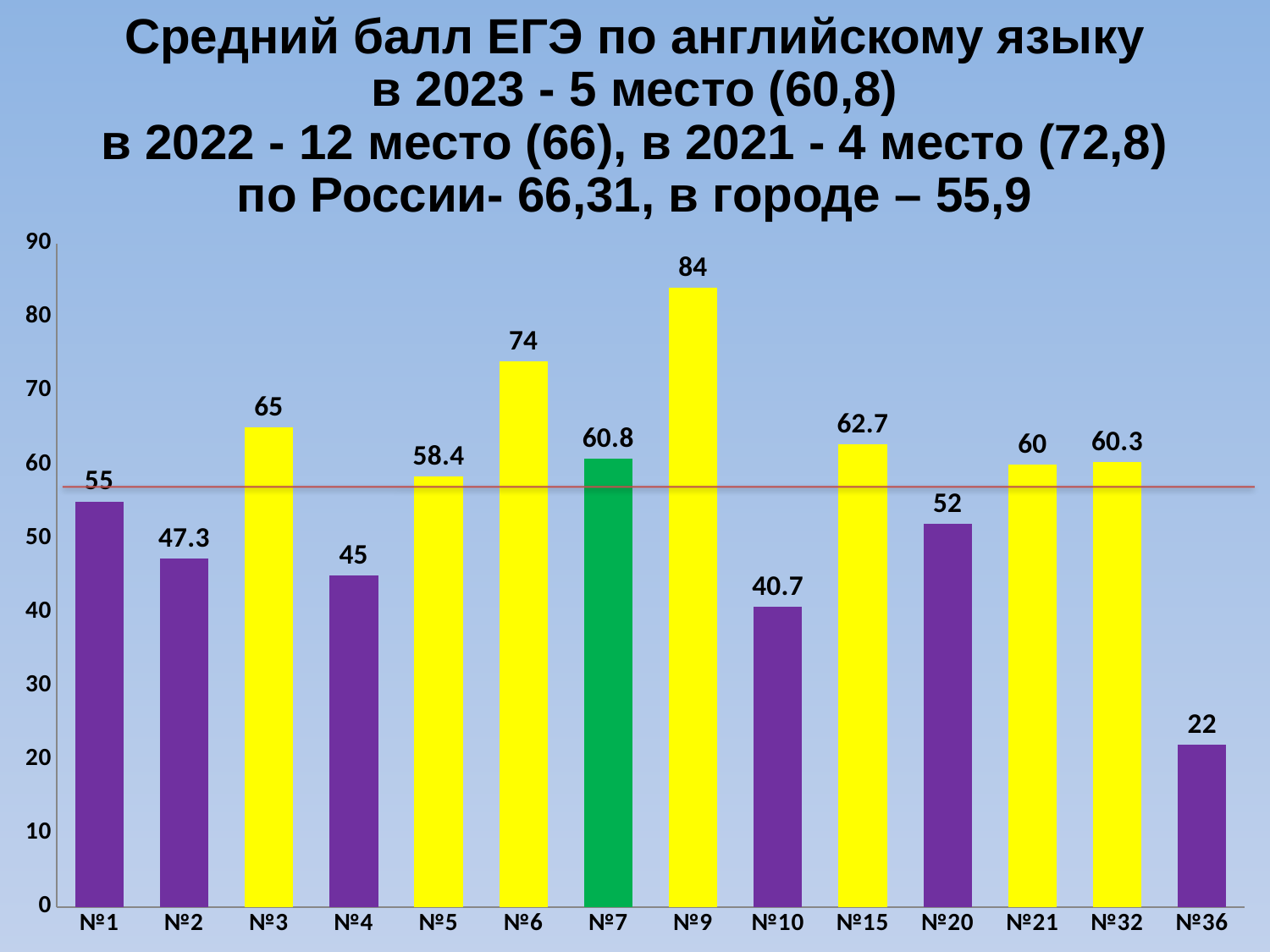
Which is larger, the value for №15 or the value for №20? №15 What is the difference between the values for №6 and №3? 9 How many categories are shown on the x axis? 14 What is the difference between the values for №9 and №36? 62 Which category has the lowest value? №36 Is the value for №4 greater or less than 50? less What is the value for №9? 84 What kind of chart is shown on the slide? bar chart Which category has the highest value? №9 What colour is the bar for №7? green What is the value for №10? 40.7 What is the value for №7? 60.8